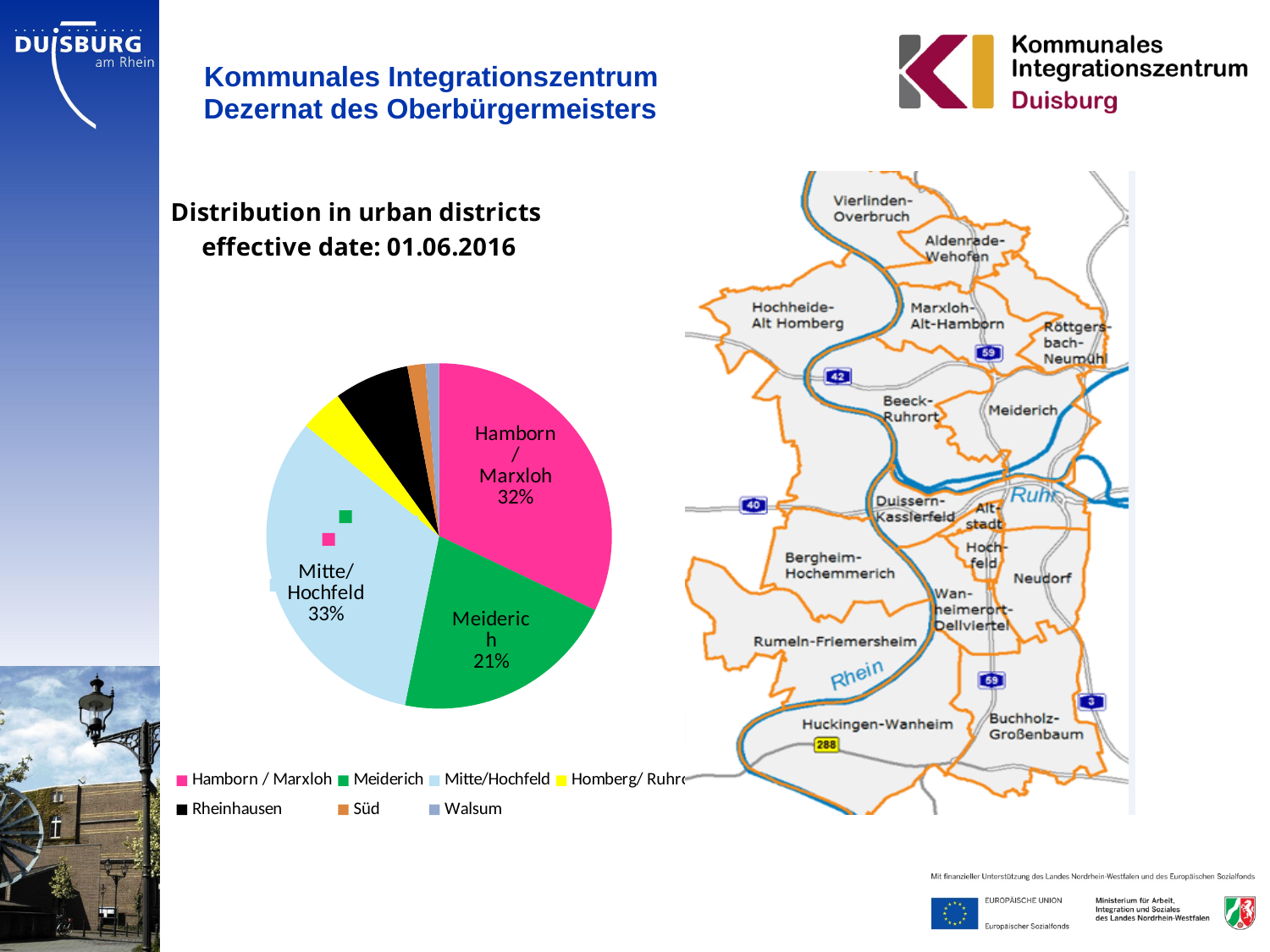
Which district has the largest share in the pie chart? Mitte/Hochfeld What colour represents Meiderich in the pie chart? Green What is the combined share of Hamborn / Marxloh, Meiderich and Mitte/Hochfeld? 86% How many districts are listed in the chart's legend? 7 Which is larger, the share for Hamborn / Marxloh or the share for Meiderich? Hamborn / Marxloh What is the effective date given in the chart's title? 01.06.2016 What is the difference in percentage points between Hamborn / Marxloh and Meiderich? 11 What type of chart is used to show the distribution in urban districts? Pie chart What share of the pie does Hamborn / Marxloh represent? 32% What is the value labelled for Mitte/Hochfeld? 33% What percentage is shown for Meiderich? 21% By how many percentage points does Mitte/Hochfeld exceed Hamborn / Marxloh? 1